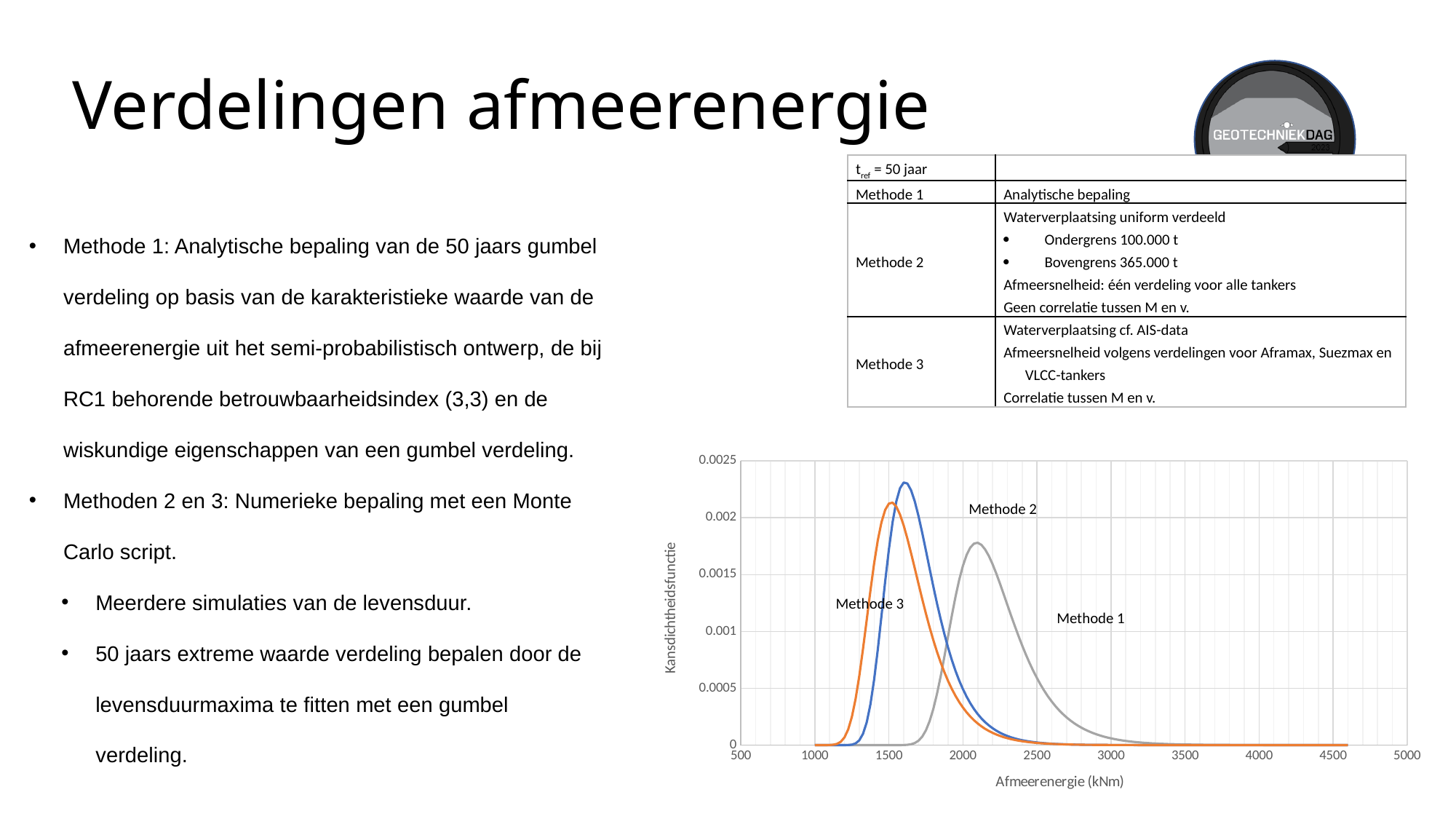
Is the peak value of the grey curve greater or less than 0.002? less Is the peak of the grey curve located at an Afmeerenergie greater or less than 2000 kNm? greater What is the title of the x axis of the chart? Afmeerenergie (kNm) Is the peak of the blue curve located at an Afmeerenergie greater or less than 2000 kNm? less Which curve has the lowest peak value on the chart? the grey curve Does the grey curve rise or fall between 2500 and 3500 kNm on the x axis? fall Which curve reaches the highest peak value on the chart? the blue curve What is the title of the y axis of the chart? Kansdichtheidsfunctie How many curves are plotted on the chart? 3 Which curve has a higher peak, the blue curve or the grey curve? the blue curve What kind of chart is shown on the slide? line chart